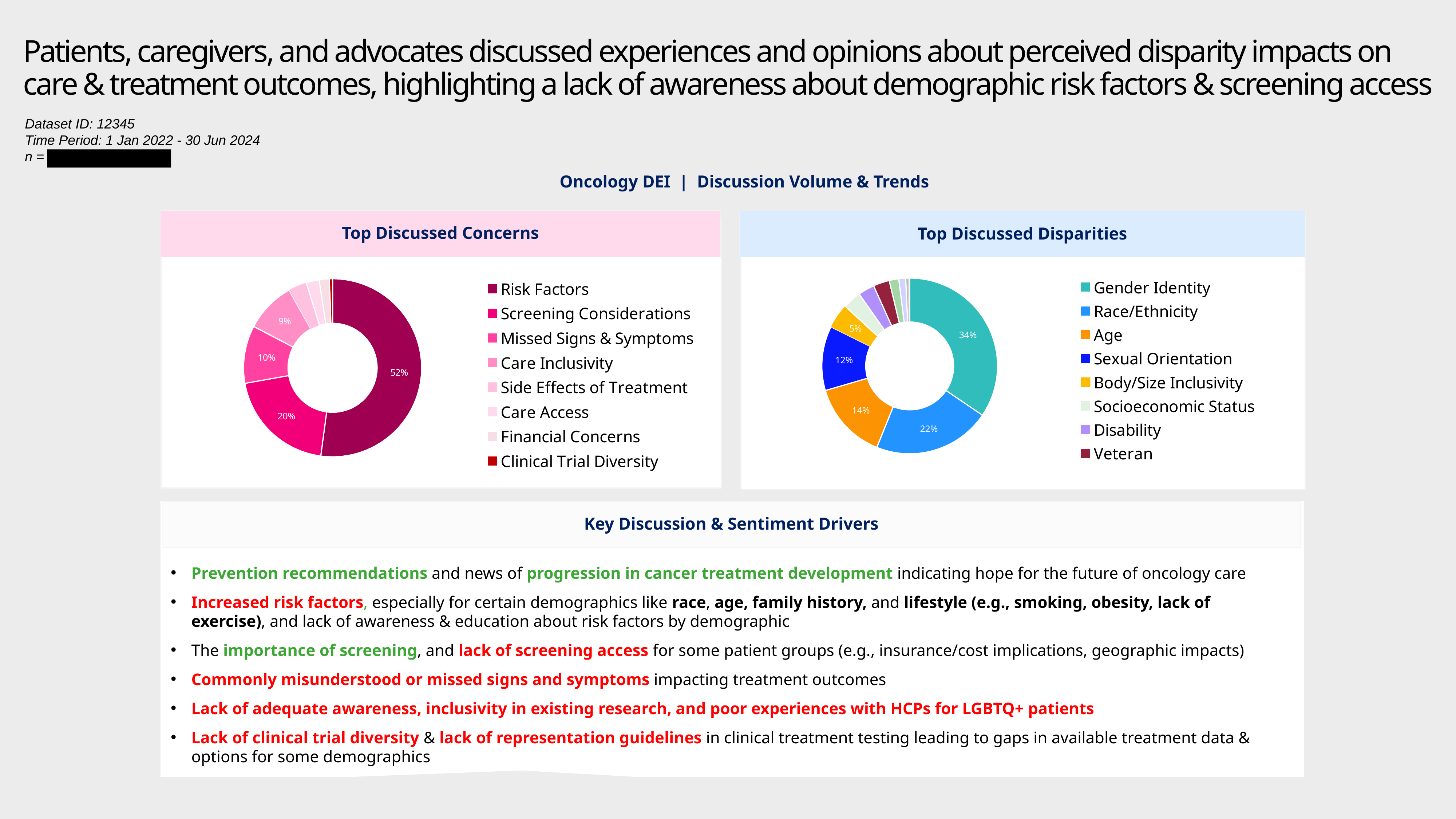
In the Top Discussed Disparities chart, what share is Gender Identity? 34% In the Top Discussed Concerns chart, what share is Risk Factors? 52% In the Top Discussed Disparities chart, which is larger, Age or Body/Size Inclusivity? Age In the Top Discussed Disparities chart, what share is Race/Ethnicity? 22% In the Top Discussed Concerns chart, which category has the largest share? Risk Factors In the Top Discussed Concerns chart, what is the difference between the Risk Factors share and the Screening Considerations share? 32% What type of chart is used for Top Discussed Disparities? Donut (pie) chart In the Top Discussed Concerns chart, what share is Missed Signs & Symptoms? 10% In the Top Discussed Disparities chart, what is the difference between the Gender Identity share and the Age share? 20% In the Top Discussed Concerns chart, what share is Screening Considerations? 20% In the Top Discussed Concerns chart, how many categories does the legend list? 8 In the Top Discussed Disparities chart, what share is Sexual Orientation? 12%